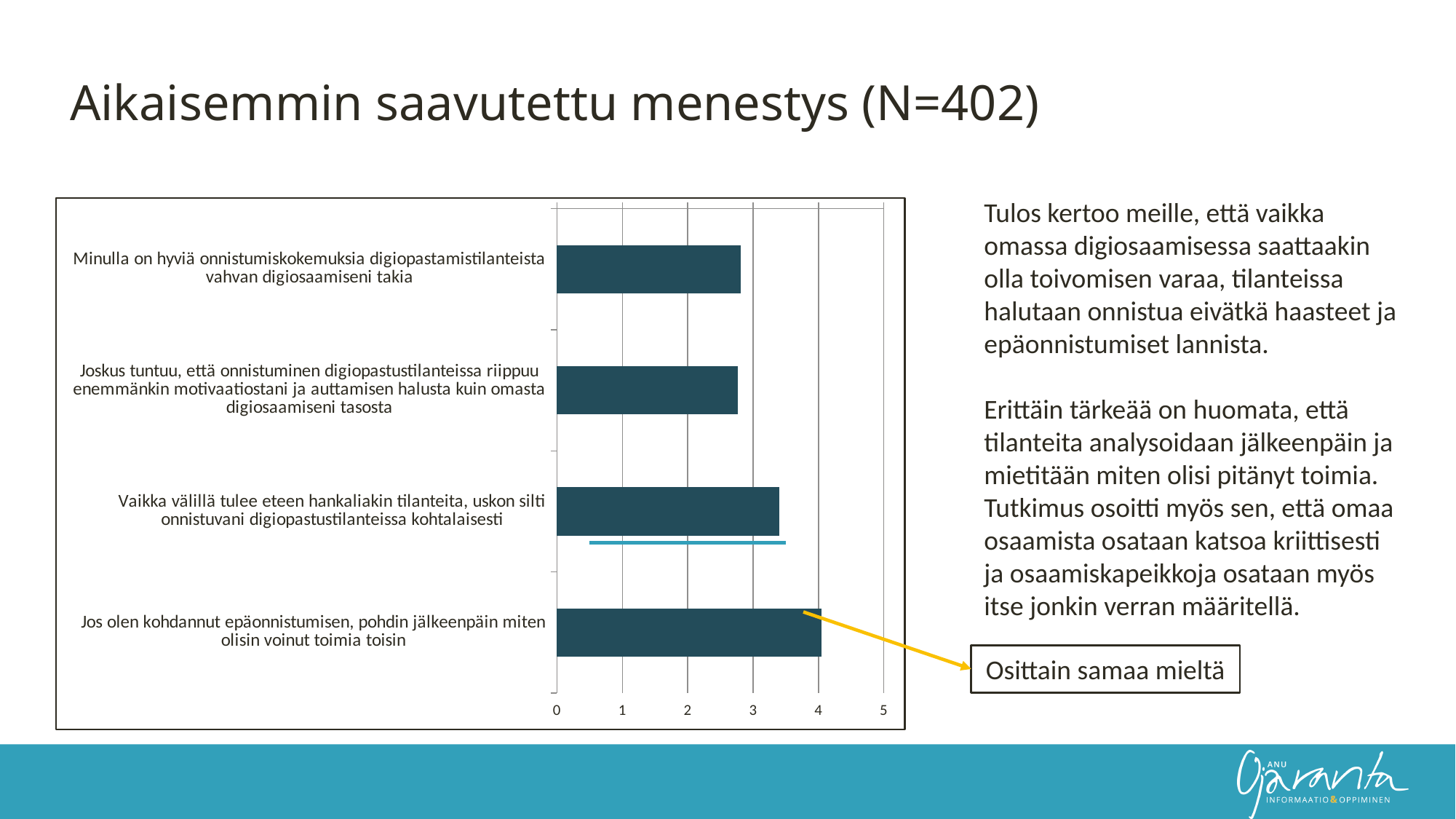
Is the value for "Minulla on hyviä onnistumiskokemuksia digiopastamistilanteista vahvan digiosaamiseni takia" greater or less than 2? greater Is the value for "Minulla on hyviä onnistumiskokemuksia digiopastamistilanteista vahvan digiosaamiseni takia" greater or less than 3? less Is the value for "Vaikka välillä tulee eteen hankaliakin tilanteita, uskon silti onnistuvani digiopastustilanteissa kohtalaisesti" greater or less than 4? less What kind of chart is shown on the slide? bar chart What does the annotation box pointing to the longest bar say? Osittain samaa mieltä How many categories (statements) does the chart show? 4 Which has the larger value: "Vaikka välillä tulee eteen hankaliakin tilanteita, uskon silti onnistuvani digiopastustilanteissa kohtalaisesti" or "Minulla on hyviä onnistumiskokemuksia digiopastamistilanteista vahvan digiosaamiseni takia"? Vaikka välillä tulee eteen hankaliakin tilanteita, uskon silti onnistuvani digiopastustilanteissa kohtalaisesti What is the highest value shown on the chart's horizontal axis? 5 Which statement has the highest value in the chart? Jos olen kohdannut epäonnistumisen, pohdin jälkeenpäin miten olisin voinut toimia toisin